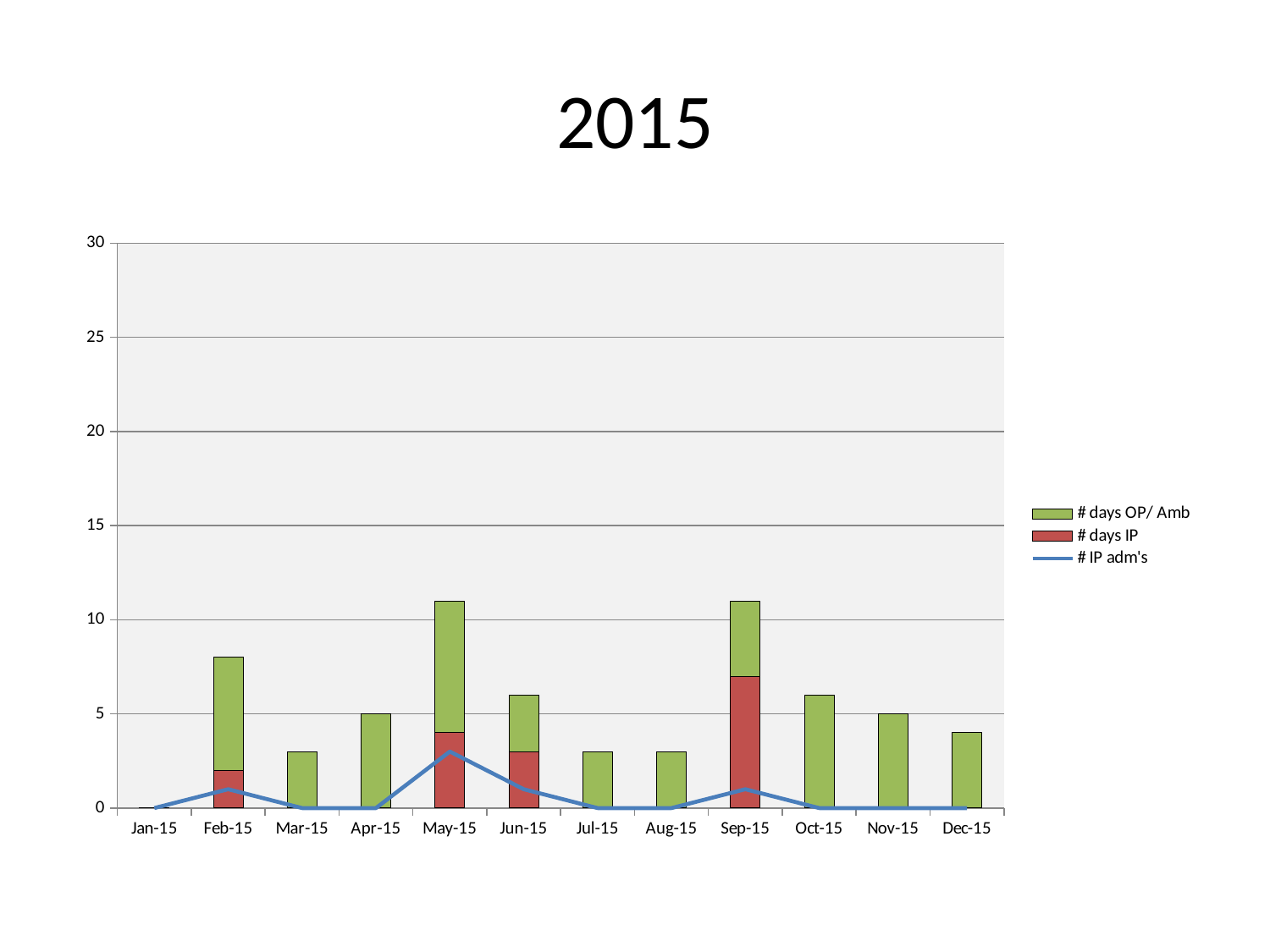
What is the value of the # IP adm's line for Jan-15? 0 How many months are shown on the x axis? 12 Is the total bar height for May-15 greater or less than 10? greater Is the total bar height for Feb-15 greater or less than 5? greater What is the title of the slide? 2015 Is the total bar height for Dec-15 greater or less than 5? less Which series is drawn as a line rather than bars? # IP adm's Which month has the lowest total bar height? Jan-15 What kind of chart is shown on the slide? A combined stacked bar and line chart How many series does the legend list? 3 Which month has the taller total bar, Feb-15 or Mar-15? Feb-15